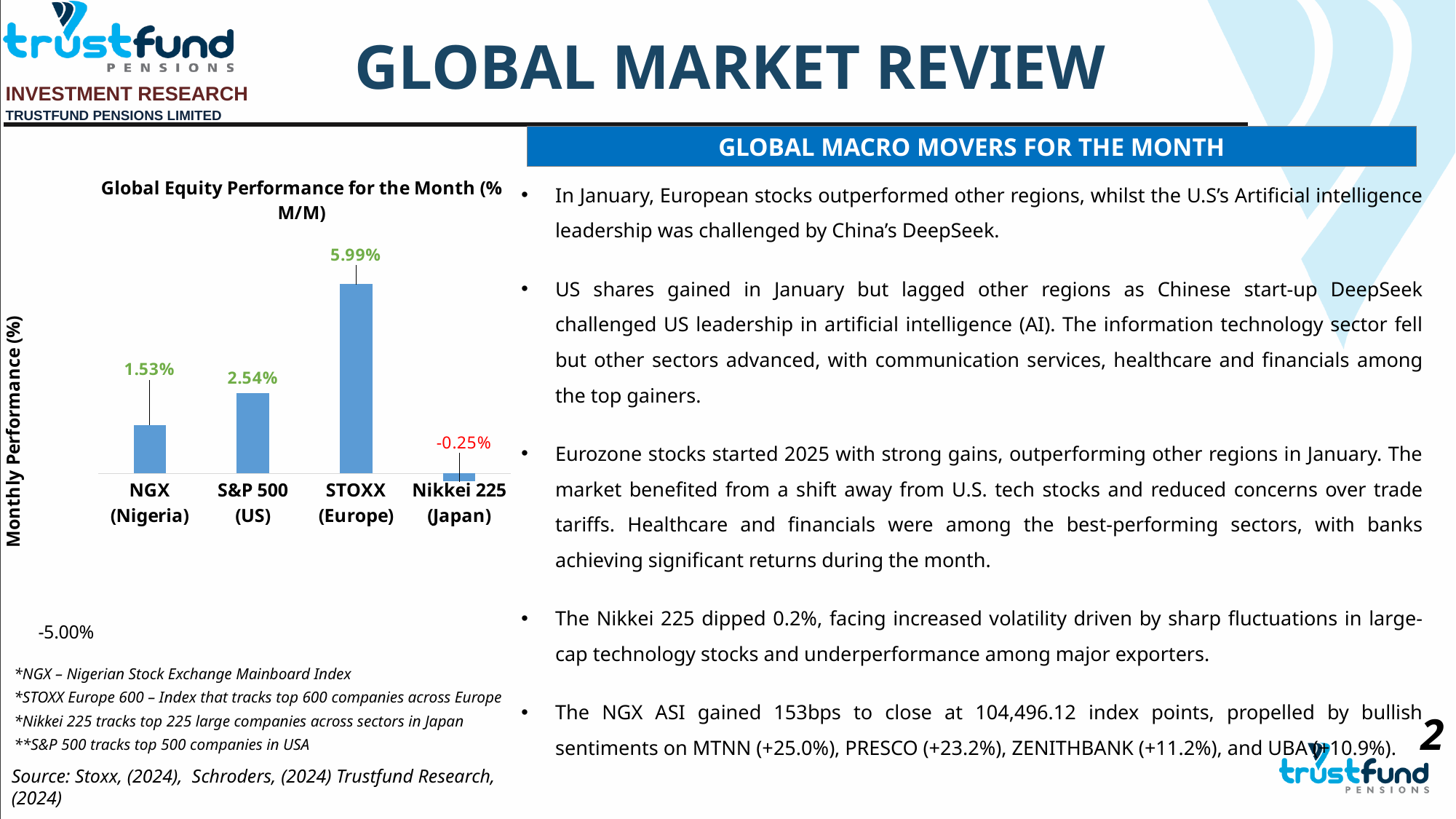
What is the value for STOXX (Europe) in the Global Equity Performance for the Month chart? 5.99% What is the value for S&P 500 (US) in the Global Equity Performance for the Month chart? 2.54% What is the value for Nikkei 225 (Japan) in the Global Equity Performance for the Month chart? -0.25% Which index has the lowest monthly performance in the chart? Nikkei 225 (Japan) Which index has the highest monthly performance in the chart? STOXX (Europe) What is the value for NGX (Nigeria) in the Global Equity Performance for the Month chart? 1.53% How many indices are shown in the Global Equity Performance for the Month chart? 4 What is the difference between the monthly performance of STOXX (Europe) and S&P 500 (US)? 3.45% Which has the larger monthly performance, NGX (Nigeria) or S&P 500 (US)? S&P 500 (US) What kind of chart is the Global Equity Performance for the Month chart? Bar chart What is the label of the vertical axis of the chart? Monthly Performance (%) What is the difference between the monthly performance of S&P 500 (US) and NGX (Nigeria)? 1.01%